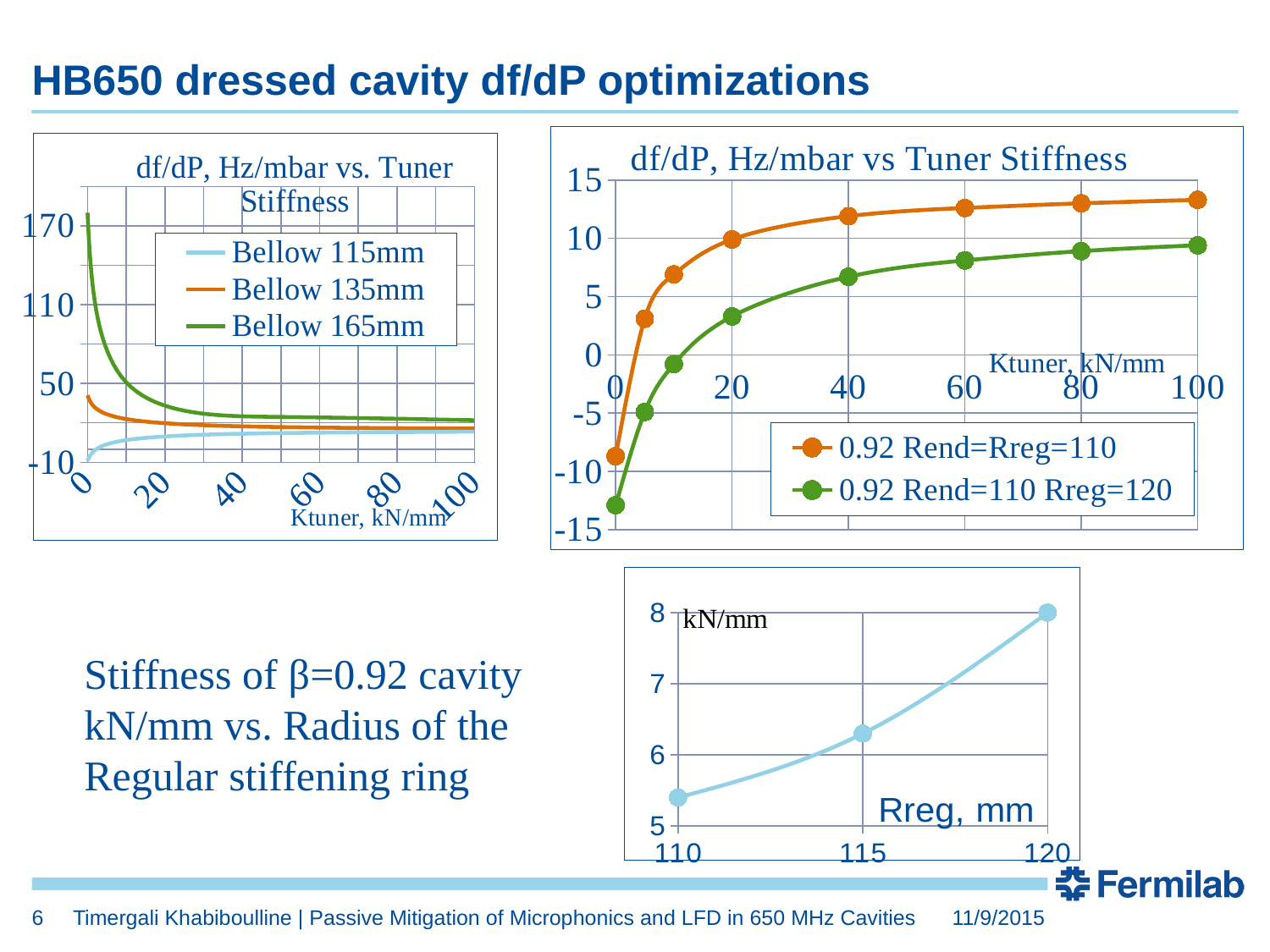
How many series does the legend of the top-right chart list? 2 In the top-right chart, does the '0.92 Rend=Rreg=110' series rise or fall as Ktuner increases? rise In the top-left chart, does the 'Bellow 165mm' series rise or fall as Ktuner increases? fall What kind of chart is the top-right chart titled 'df/dP, Hz/mbar vs Tuner Stiffness'? line chart In the top-left chart, which series has the highest value at Ktuner=0? Bellow 165mm In the top-right chart, at Ktuner=40, which series has the larger value: '0.92 Rend=Rreg=110' or '0.92 Rend=110 Rreg=120'? 0.92 Rend=Rreg=110 In the bottom-right chart, how many data points are plotted? 3 What is the x-axis label of the bottom-right chart? Rreg, mm In the bottom-right chart, does the stiffness rise or fall as Rreg increases from 110 to 120? rise In the top-right chart, is the value of the '0.92 Rend=Rreg=110' series at Ktuner=100 greater or less than 10? greater How many series does the legend of the top-left chart list? 3 In the top-right chart, is the value of the '0.92 Rend=110 Rreg=120' series at Ktuner=0 greater or less than -10? less